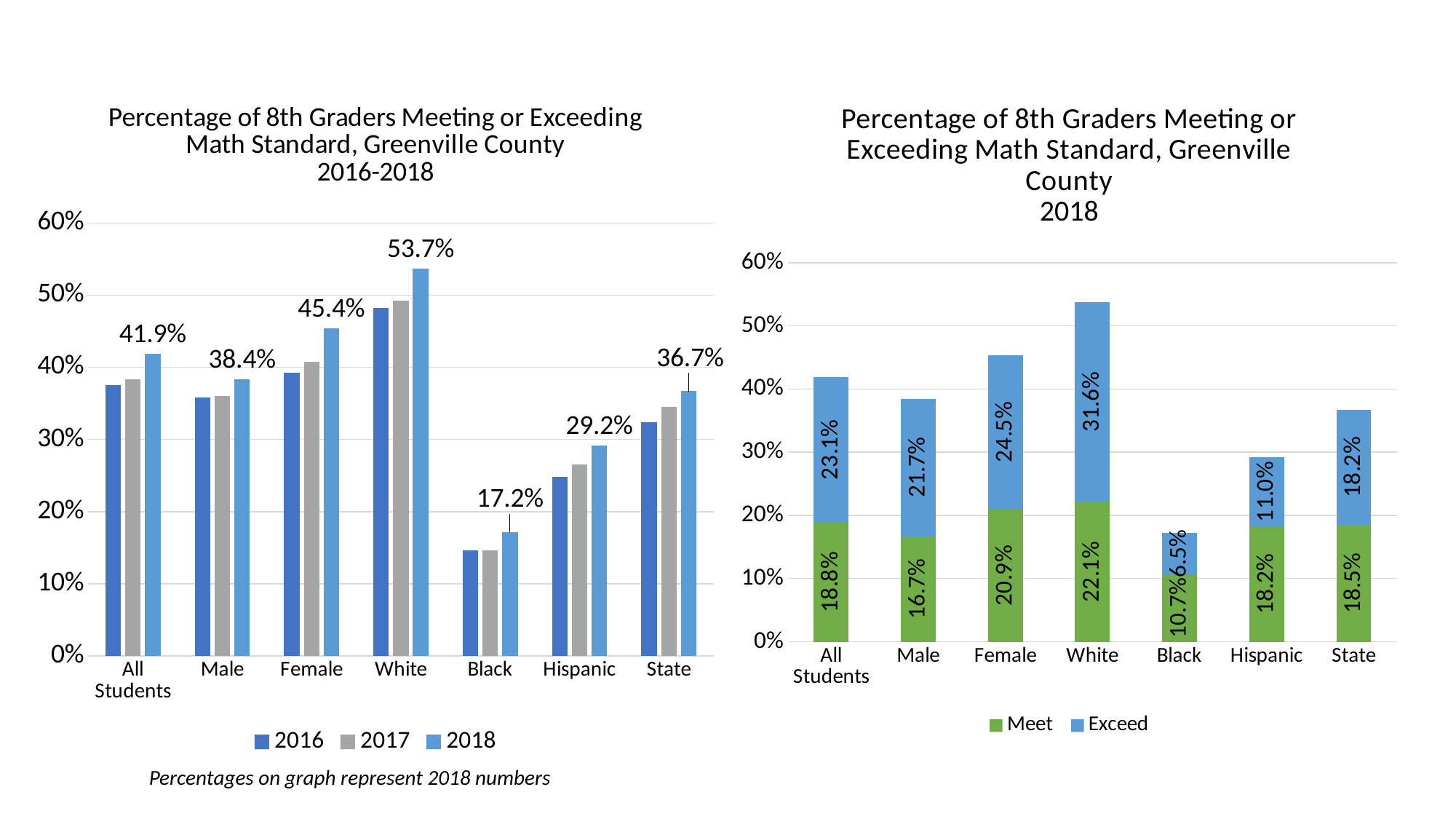
In the right chart (2018), what is the total of the stacked bar for Female? 45.4% In the left chart (2016-2018), which category has the lowest 2018 value? Black In the left chart (2016-2018), what is the difference between the 2018 values for White and Black? 36.5 percentage points In the right chart (2018), what is the Exceed value for White? 31.6% In the left chart (2016-2018), what is the 2018 value for White? 53.7% In the right chart (2018), which is larger for Hispanic, Meet or Exceed? Meet What kind of chart is the left chart (2016-2018)? Bar chart In the right chart (2018), how many categories are shown on the x axis? 7 In the left chart (2016-2018), how many series does the legend list? 3 In the left chart (2016-2018), is the 2016 value for Hispanic greater or less than 30%? less In the right chart (2018), what is the Meet value for Black? 10.7% In the left chart (2016-2018), which category has the highest 2018 value? White